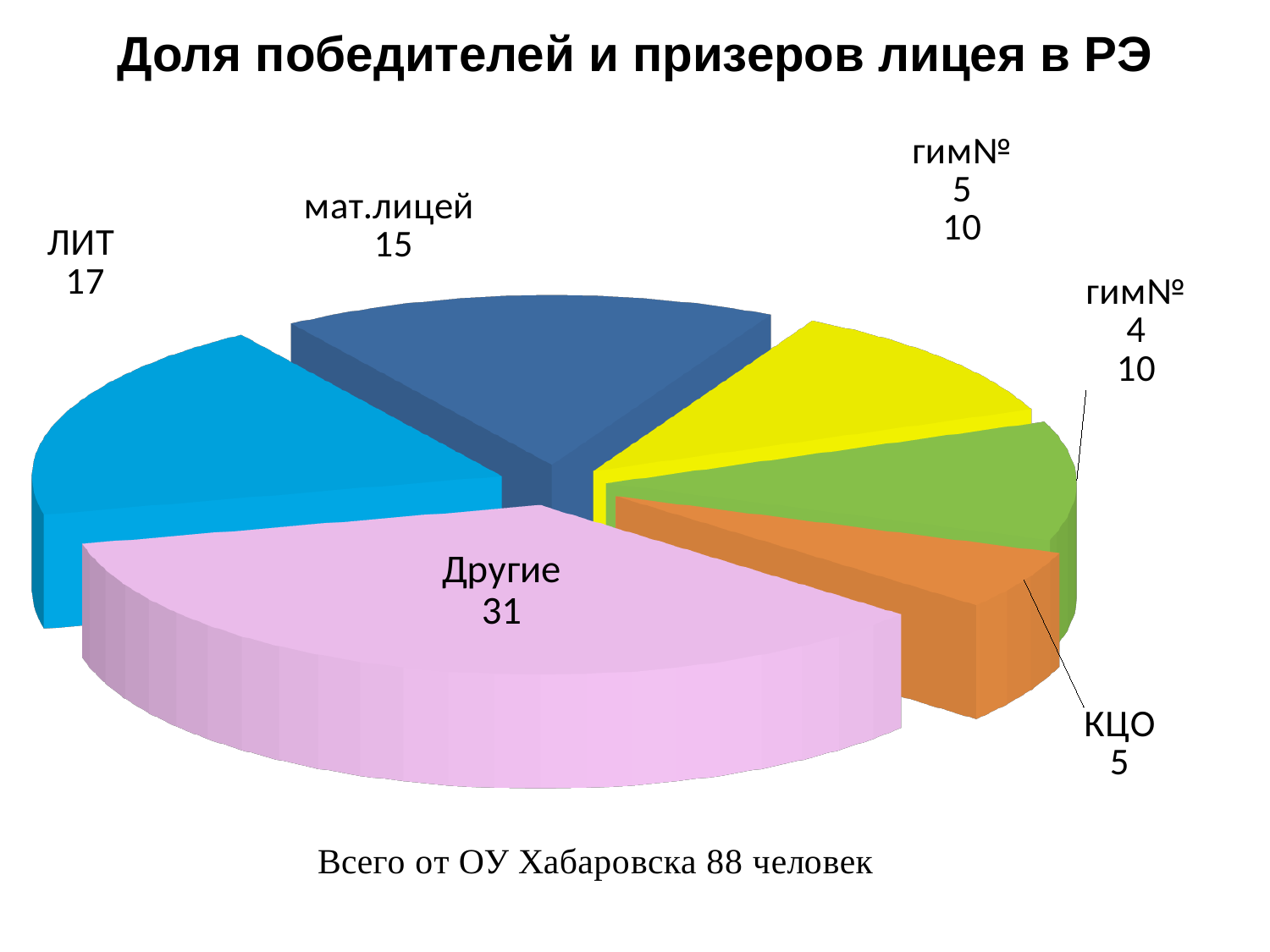
What is the value for ЛИТ? 17 What is the total of all slices in the pie chart? 88 What kind of chart is shown on the slide? pie chart What is the title of the chart? Доля победителей и призеров лицея в РЭ What is the value for КЦО? 5 How many slices does the pie chart have? 6 Which category has the largest slice? Другие What is the value for мат.лицей? 15 Which is larger, the value for ЛИТ or the value for мат.лицей? ЛИТ Which category has the smallest slice? КЦО What is the difference between the values for Другие and ЛИТ? 14 What is the value for Другие? 31